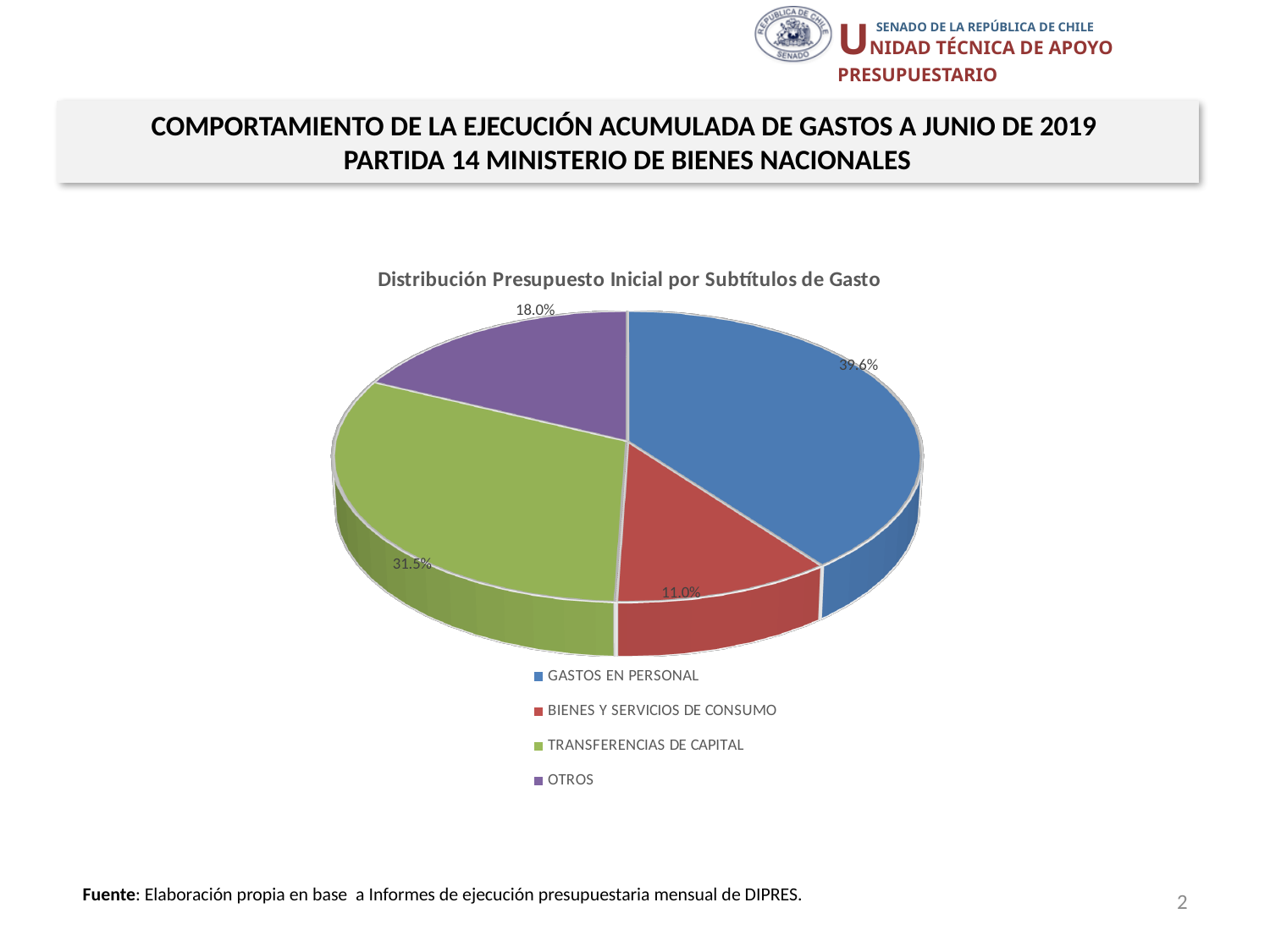
What is the difference in percentage points between GASTOS EN PERSONAL and TRANSFERENCIAS DE CAPITAL? 8.1 What share of the pie does BIENES Y SERVICIOS DE CONSUMO represent? 11.0% What kind of chart is shown on the slide? Pie chart What colour is the slice for TRANSFERENCIAS DE CAPITAL? Green What share of the pie does OTROS represent? 18.0% Which category has the largest slice of the pie? GASTOS EN PERSONAL What share of the pie does GASTOS EN PERSONAL represent? 39.6% Which is larger, the share for OTROS or the share for BIENES Y SERVICIOS DE CONSUMO? OTROS What is the title of the chart? Distribución Presupuesto Inicial por Subtítulos de Gasto How many categories are shown in the pie chart? 4 Which category has the smallest slice of the pie? BIENES Y SERVICIOS DE CONSUMO